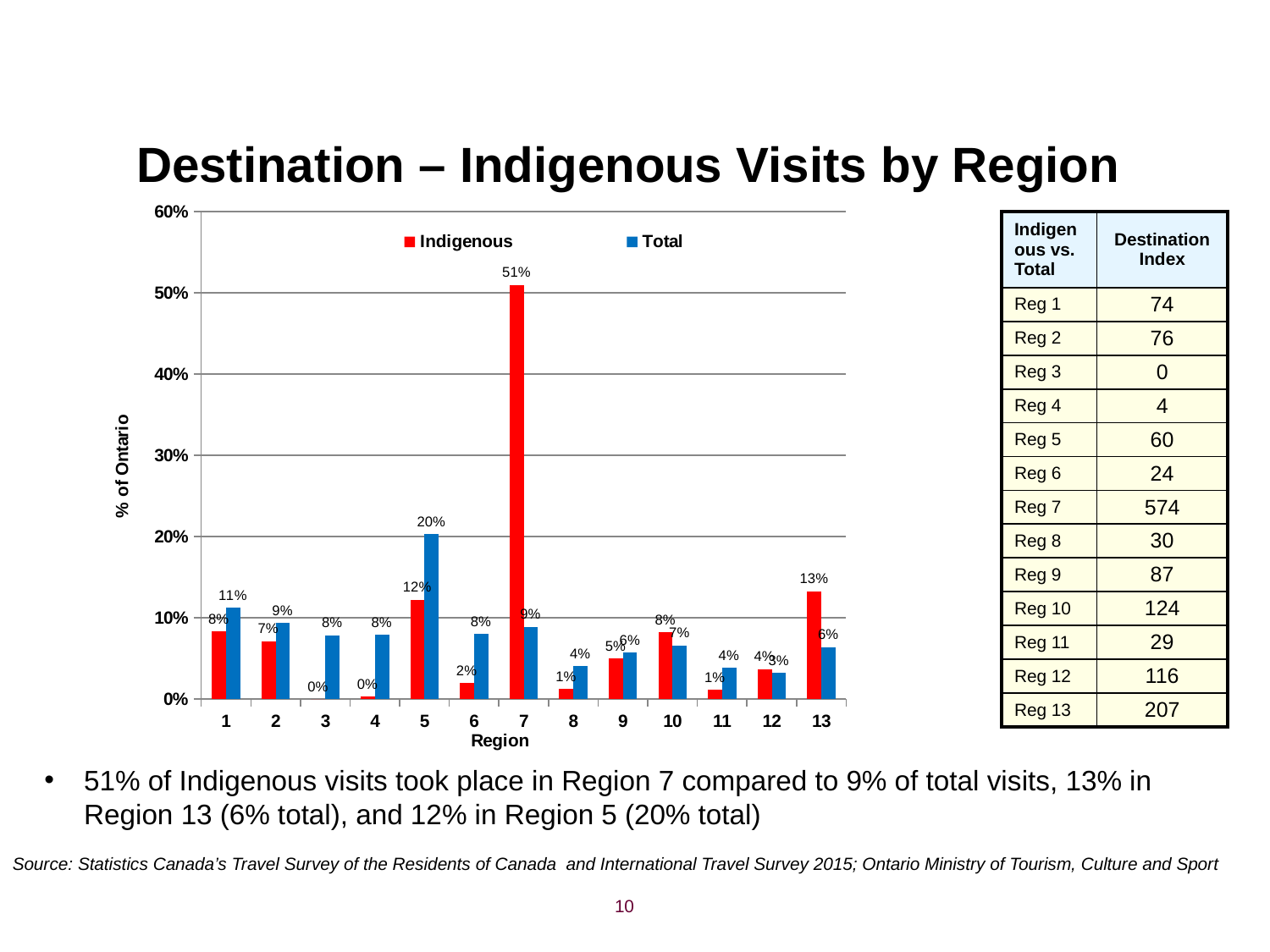
What is the Indigenous value for Region 13? 13% Which region has the highest Indigenous value? 7 What is the Total value for Region 5? 20% Is the Indigenous value for Region 7 greater or less than 40%? greater What is the Indigenous value for Region 7? 51% Which is larger for Region 5, the Indigenous value or the Total value? Total How many series does the legend list? 2 What kind of chart is shown on the slide? bar chart How many regions are shown on the x axis? 13 What is the Total value for Region 1? 11% Which region has the highest Total value? 5 What is the difference between the Indigenous and Total values for Region 7? 42%